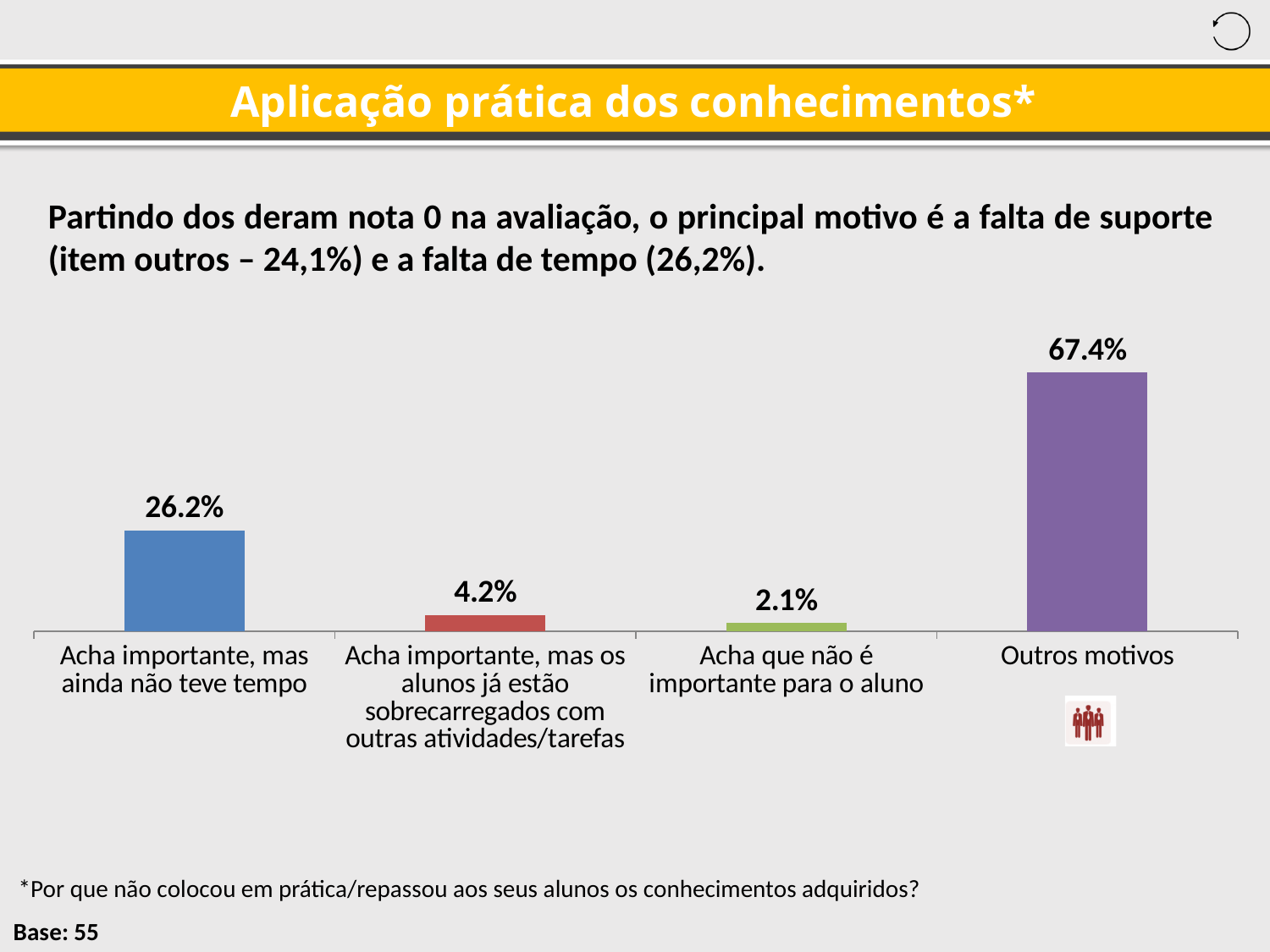
What is the value for "Acha importante, mas ainda não teve tempo"? 26.2% What is the value for "Outros motivos"? 67.4% What kind of chart is shown on the slide? Bar chart What is the difference between the values for "Outros motivos" and "Acha importante, mas ainda não teve tempo"? 41.2% How many categories are shown in the chart? 4 Which category has the lowest value? Acha que não é importante para o aluno What is the value for "Acha importante, mas os alunos já estão sobrecarregados com outras atividades/tarefas"? 4.2% What is the difference between the values for "Acha importante, mas os alunos já estão sobrecarregados com outras atividades/tarefas" and "Acha que não é importante para o aluno"? 2.1% Which is larger: the value for "Acha importante, mas ainda não teve tempo" or the value for "Acha importante, mas os alunos já estão sobrecarregados com outras atividades/tarefas"? Acha importante, mas ainda não teve tempo Which category has the highest value? Outros motivos What is the value for "Acha que não é importante para o aluno"? 2.1% What colour is the bar for "Outros motivos"? Purple